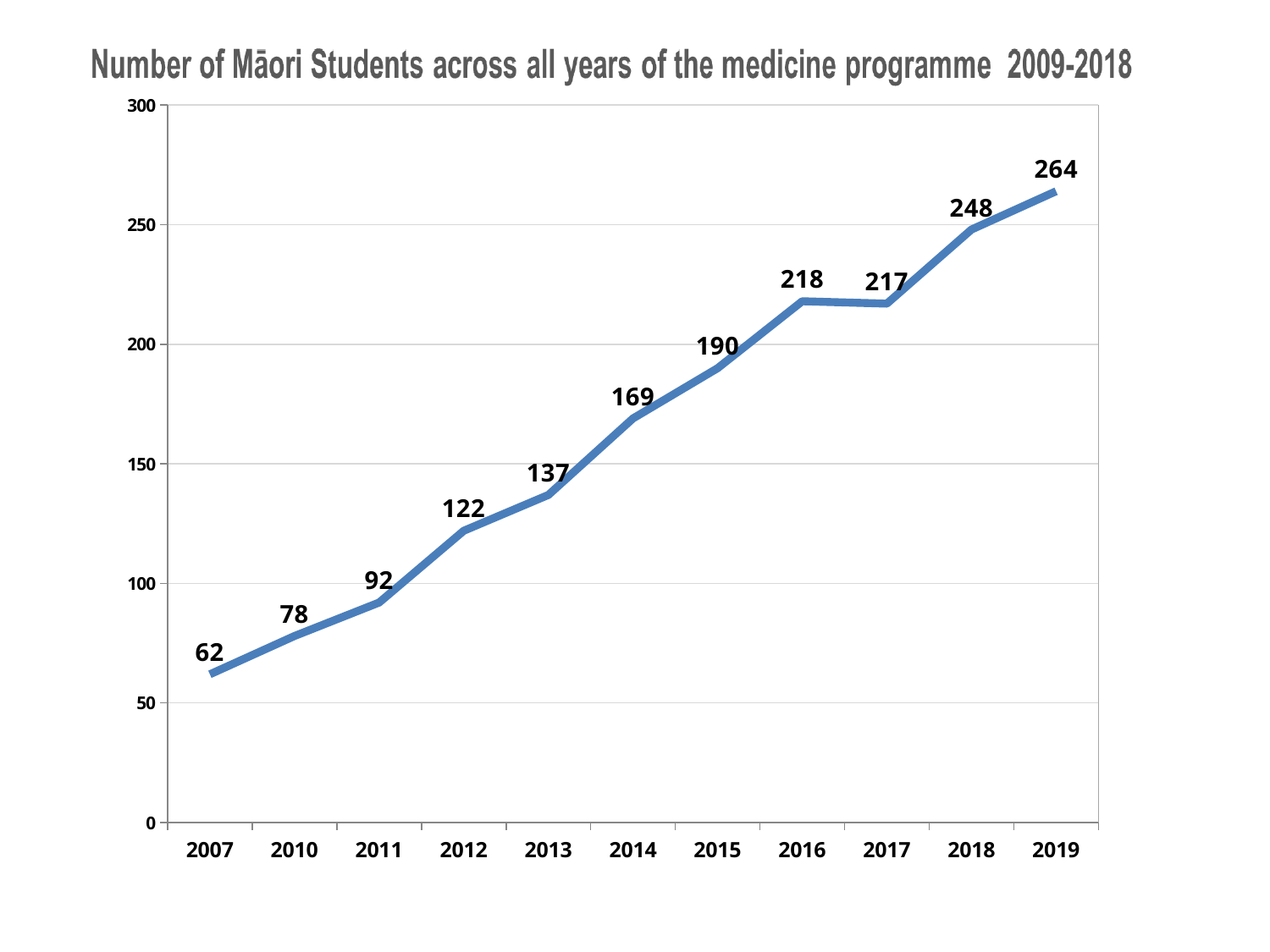
What is the difference between the values for 2016 and 2017? 1 Which year has the lowest number of Māori students? 2007 Is the value for 2012 greater or less than 100? greater What is the number of Māori students in 2007? 62 Do the values generally rise or fall from 2007 to 2019? rise Which year has the highest number of Māori students? 2019 What is the number of Māori students in 2014? 169 How many years are plotted on the x axis? 11 What kind of chart is shown on the slide? line chart Which year has a larger value, 2013 or 2015? 2015 What is the difference between the number of Māori students in 2019 and in 2007? 202 What is the number of Māori students in 2019? 264